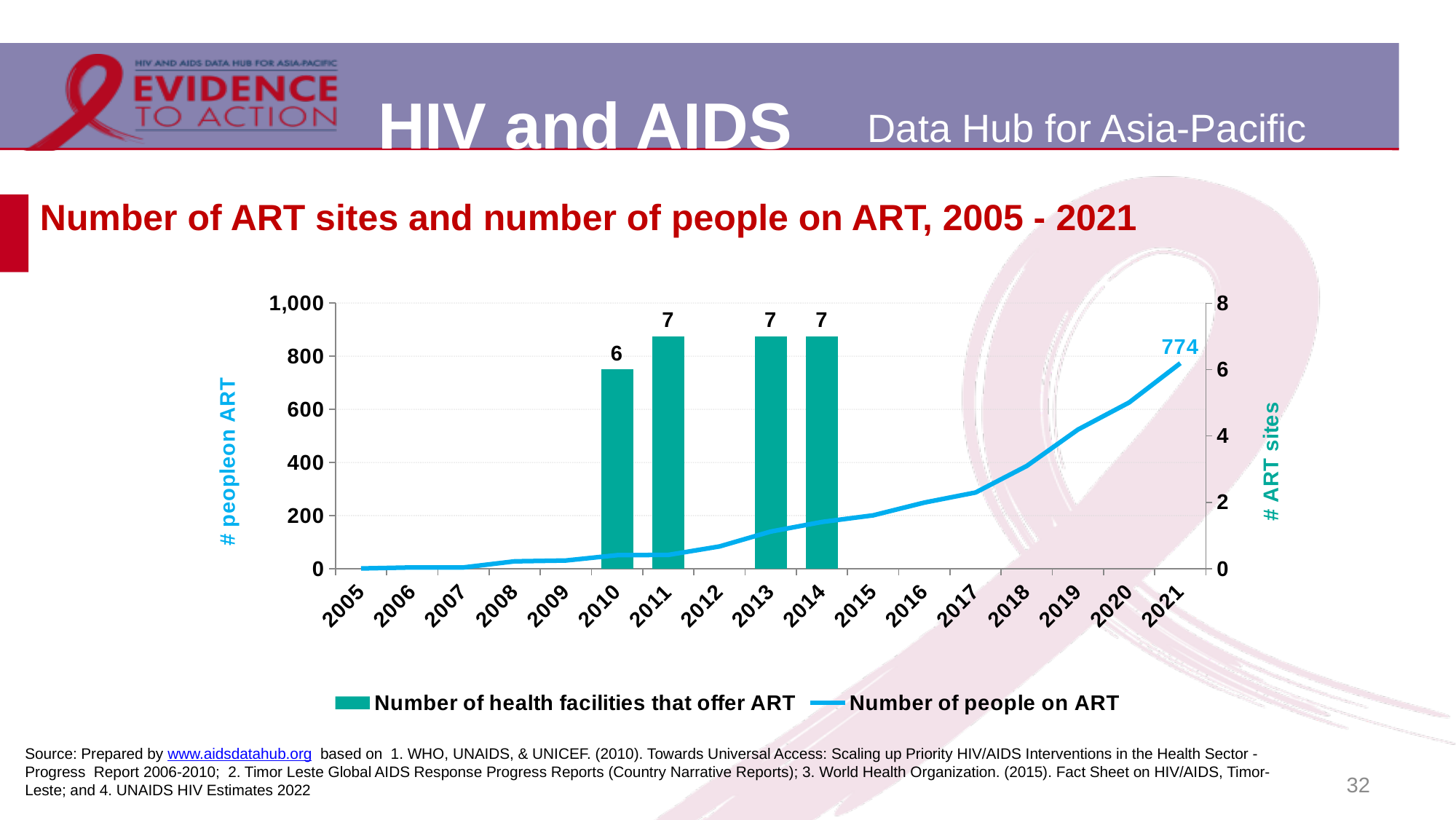
Is the number of health facilities that offer ART larger in 2011 or in 2010? 2011 How many years are shown on the x axis? 17 What is the number of people on ART in 2021? 774 Is the number of people on ART in 2015 greater or less than 400? less What is the difference between the number of health facilities that offer ART in 2011 and in 2010? 1 How many series does the legend list? 2 How many health facilities offered ART in 2010? 6 Does the number of people on ART rise or fall from 2005 to 2021? rise Which year has the lowest labelled number of health facilities that offer ART? 2010 How many health facilities offered ART in 2013? 7 Is the number of people on ART in 2019 greater or less than 400? greater What is the label of the right-hand vertical axis? # ART sites